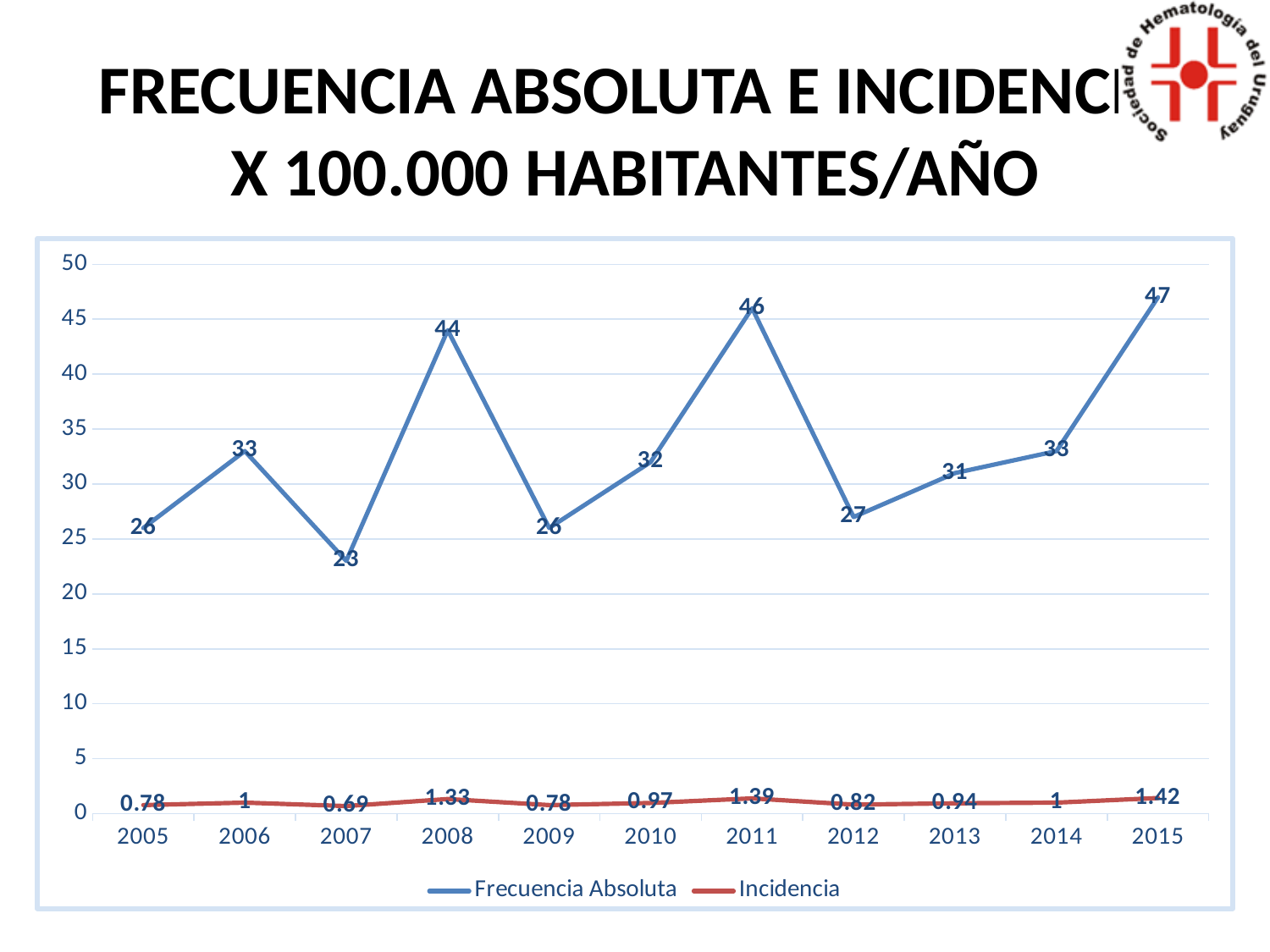
Which year has the lowest Frecuencia Absoluta? 2007 What is the Frecuencia Absoluta value for 2008? 44 Is the Frecuencia Absoluta value for 2012 greater or less than 30? less How many years are plotted on the x axis? 11 Which year has the lowest Incidencia? 2007 What kind of chart is shown on the slide? line chart Which is larger, the Frecuencia Absoluta for 2011 or for 2008? 2011 Which year has the highest Frecuencia Absoluta? 2015 How many series does the legend list? 2 What is the difference in Frecuencia Absoluta between 2015 and 2014? 14 Does the Frecuencia Absoluta rise or fall from 2012 to 2015? rise What is the Incidencia value for 2011? 1.39